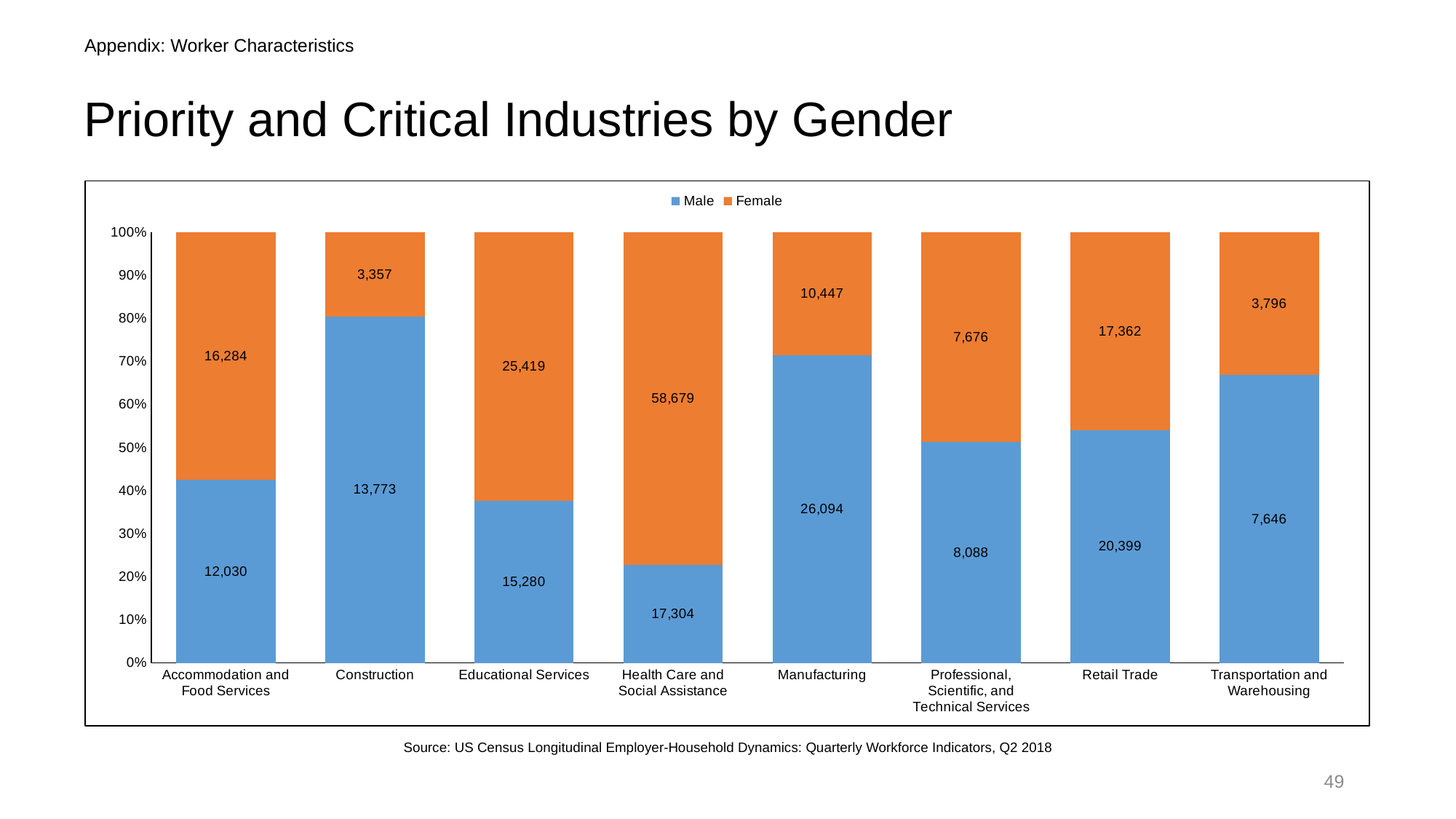
How many industries are shown on the x axis? 8 What kind of chart is shown on the slide? Stacked bar chart Is the Male share of the Construction bar greater or less than 70%? greater What is the Female value for Construction? 3,357 Which industry has the lowest Male value? Transportation and Warehousing How many series does the legend list? 2 What is the difference between the Male and Female values for Manufacturing? 15,647 What is the total of the Health Care and Social Assistance bar (Male plus Female)? 75,983 What is the Female value for Health Care and Social Assistance? 58,679 Which is larger for Retail Trade, the Male value or the Female value? Male What is the Male value for Manufacturing? 26,094 Which industry has the highest Female value? Health Care and Social Assistance